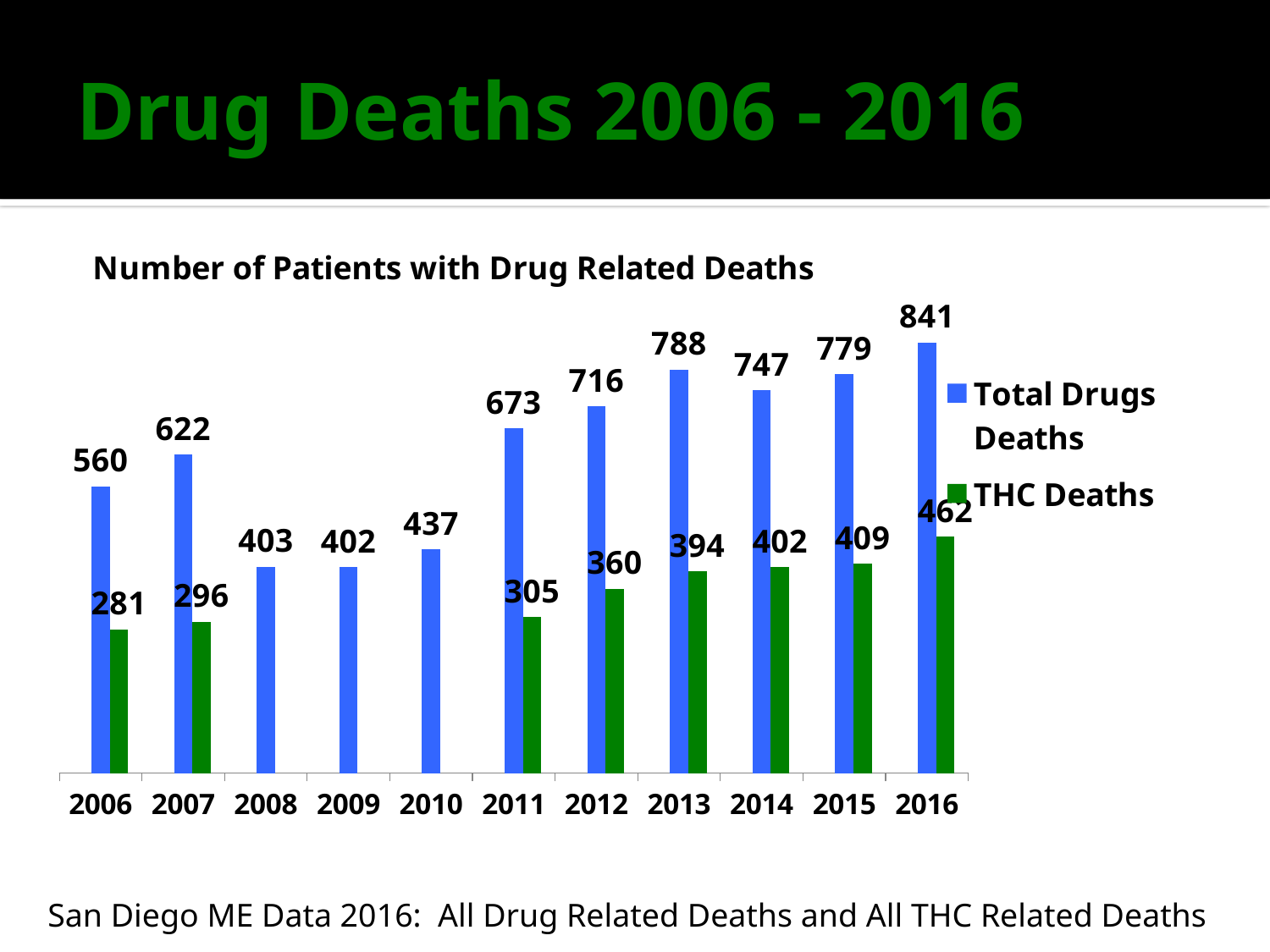
What is the value of Total Drugs Deaths for 2016? 841 What is the value of Total Drugs Deaths for 2009? 402 What is the value of THC Deaths for 2012? 360 How many years are shown on the x axis? 11 What kind of chart is shown on the slide? bar chart Which year has the highest Total Drugs Deaths? 2016 What is the difference between Total Drugs Deaths and THC Deaths in 2016? 379 Which year has the lowest THC Deaths among the years with a THC Deaths bar? 2006 Do the THC Deaths values rise or fall from 2011 to 2016? rise Which is larger, Total Drugs Deaths in 2013 or in 2015? 2013 How many series does the legend list? 2 What is the title of the chart? Number of Patients with Drug Related Deaths